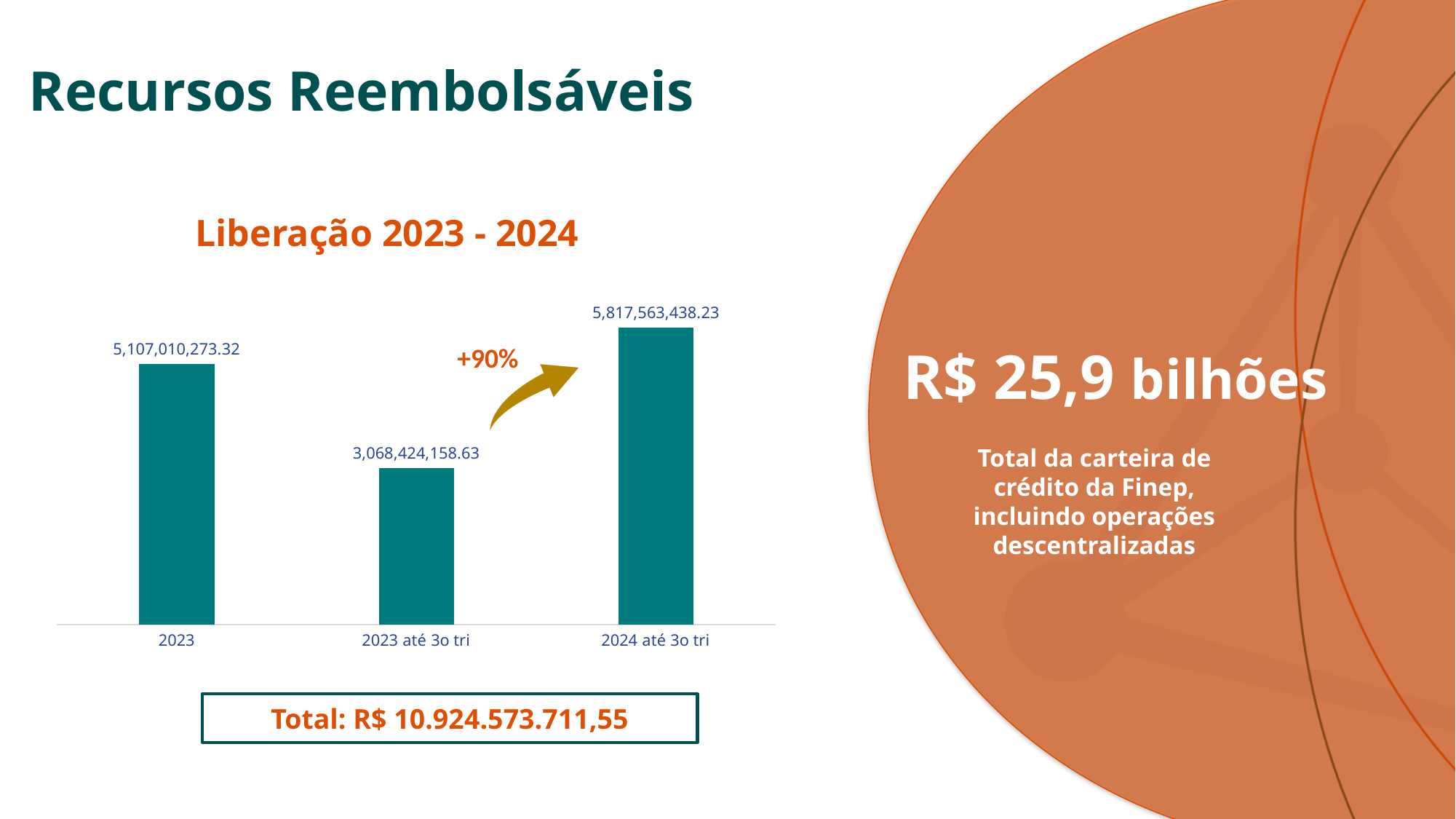
What percentage change is annotated on the arrow between 2023 até 3o tri and 2024 até 3o tri? +90% What is the value for 2024 até 3o tri in the chart? 5,817,563,438.23 Does the value rise or fall from 2023 até 3o tri to 2024 até 3o tri? Rises What is the difference between the values for 2024 até 3o tri and 2023? 710,553,164.91 What is the value for 2023 in the Liberação 2023 - 2024 chart? 5,107,010,273.32 Which category has the lowest value in the chart? 2023 até 3o tri Which is larger, the value for 2023 or the value for 2024 até 3o tri? 2024 até 3o tri Which category has the highest value in the chart? 2024 até 3o tri What kind of chart is shown on the slide? Bar chart How many bars are shown in the chart? 3 What is the difference between the values for 2024 até 3o tri and 2023 até 3o tri? 2,749,139,279.60 What is the value for 2023 até 3o tri in the chart? 3,068,424,158.63